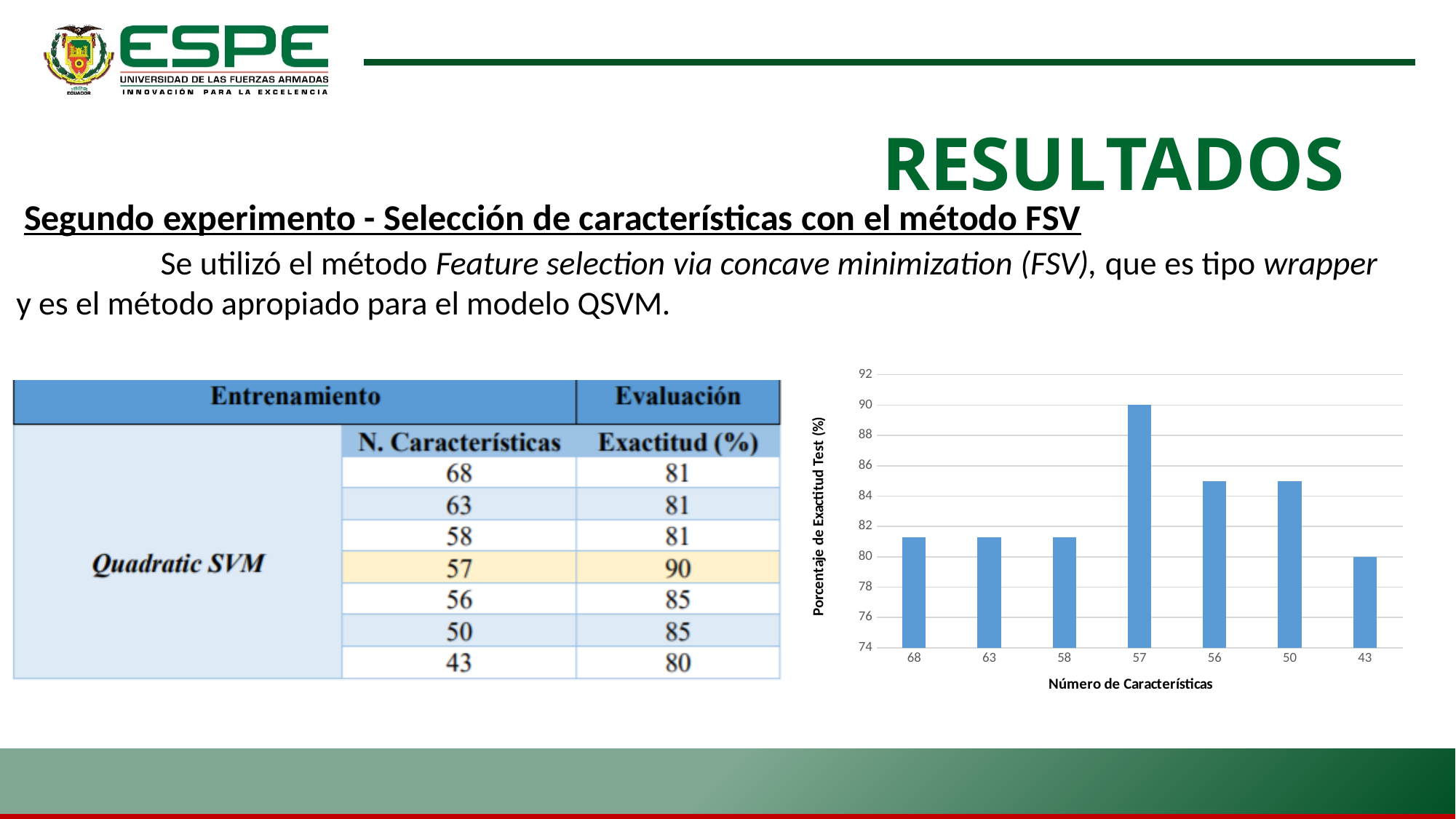
Is the value for 68 features greater or less than 82? less Is the value for 56 features greater or less than 84? greater Which is larger in the chart, the value for 56 features or the value for 43 features? 56 features Is the value for 50 features greater or less than 86? less What is the label of the horizontal axis of the chart? Número de Características Which number of features has the lowest test accuracy in the chart? 43 How many bars does the chart show? 7 What is the test accuracy percentage for 57 features in the chart? 90 What is the label of the vertical axis of the chart? Porcentaje de Exactitud Test (%) What kind of chart is shown on the slide? bar chart Which number of features has the highest test accuracy in the chart? 57 What is the test accuracy percentage for 43 features in the chart? 80